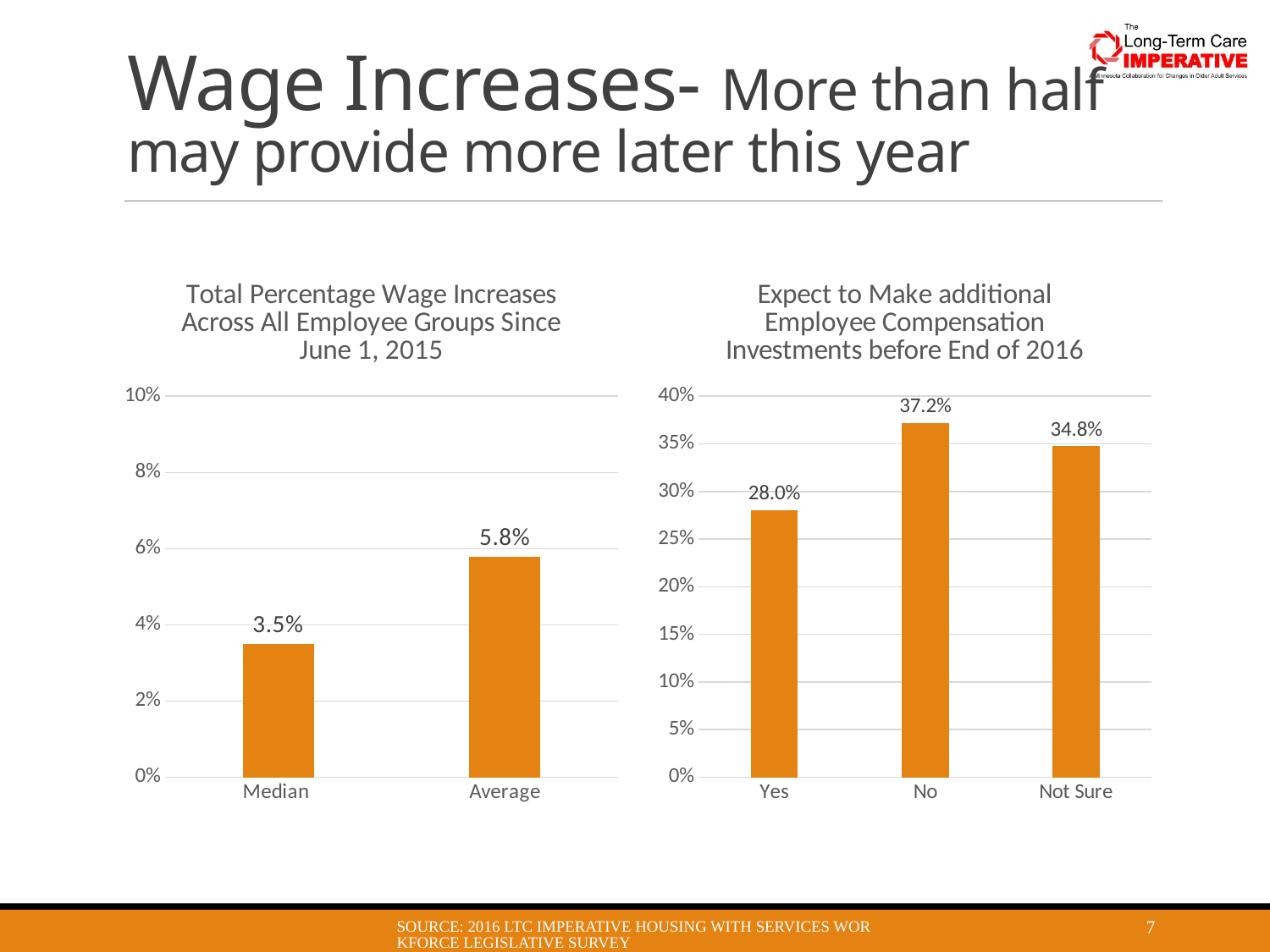
In the left chart (Total Percentage Wage Increases), what is the difference between the Average and Median values? 2.3% In the right chart (Expect to Make additional Employee Compensation Investments), what is the difference between the No and Not Sure values? 2.4% In the left chart (Total Percentage Wage Increases Across All Employee Groups Since June 1, 2015), what is the value for Average? 5.8% In the left chart (Total Percentage Wage Increases Across All Employee Groups Since June 1, 2015), what is the value for Median? 3.5% In the right chart (Expect to Make additional Employee Compensation Investments), which category has the highest value? No In the right chart (Expect to Make additional Employee Compensation Investments before End of 2016), what is the value for Yes? 28.0% In the left chart (Total Percentage Wage Increases), which category has the higher value, Median or Average? Average In the left chart (Total Percentage Wage Increases), how many categories are shown? 2 In the right chart (Expect to Make additional Employee Compensation Investments), which category has the lowest value? Yes What kind of chart is the right chart (Expect to Make additional Employee Compensation Investments before End of 2016)? Bar chart In the right chart (Expect to Make additional Employee Compensation Investments before End of 2016), what is the value for Not Sure? 34.8% In the right chart (Expect to Make additional Employee Compensation Investments before End of 2016), what is the value for No? 37.2%